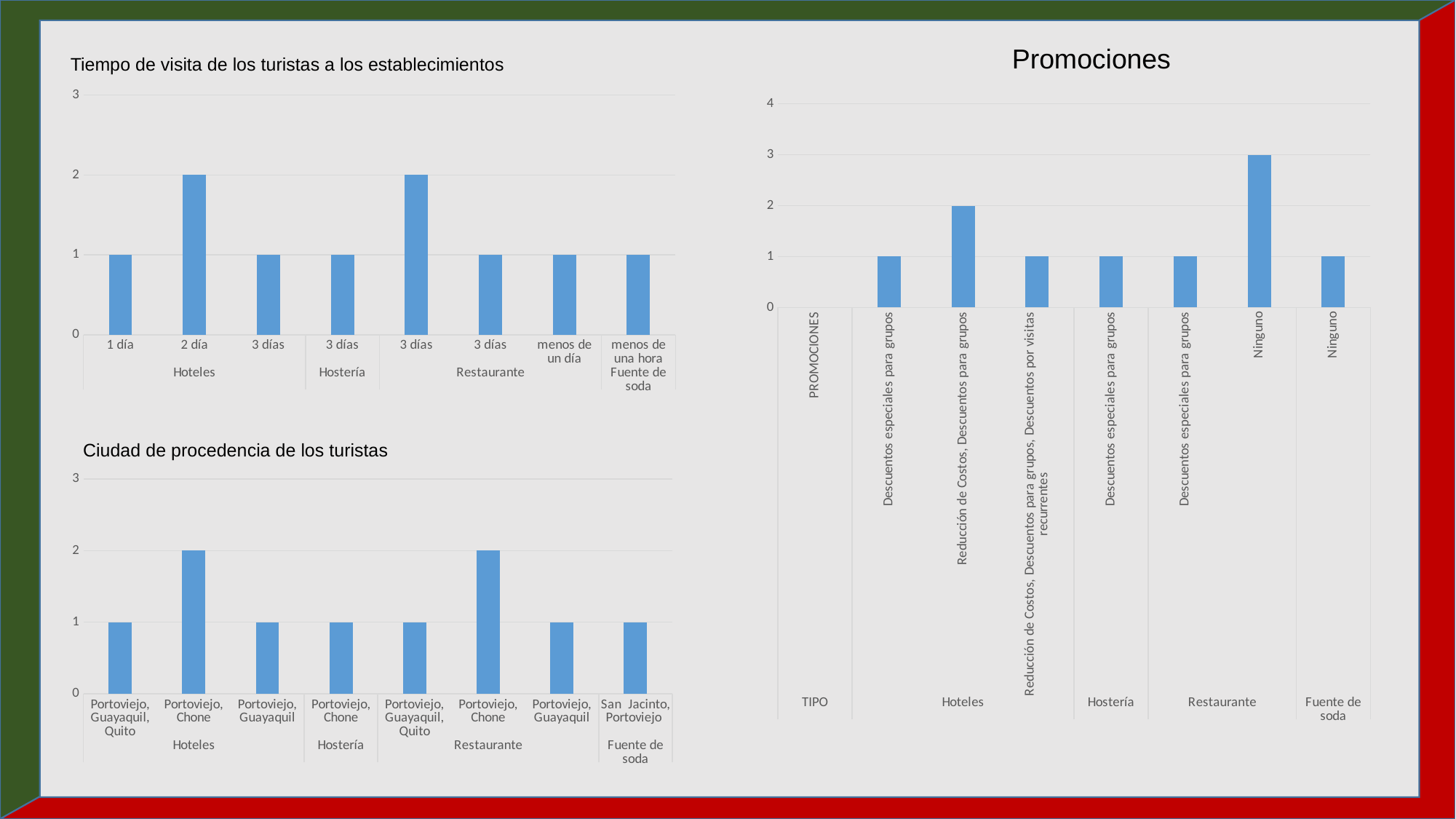
In the 'Promociones' chart, what is the value for 'Reducción de Costos, Descuentos para grupos' under Hoteles? 2 In the 'Tiempo de visita de los turistas a los establecimientos' chart, what is the value for 'menos de una hora' under Fuente de soda? 1 In the 'Ciudad de procedencia de los turistas' chart, what is the value for 'Portoviejo, Chone' under Hoteles? 2 In the 'Tiempo de visita de los turistas a los establecimientos' chart, what is the value for '2 día' under Hoteles? 2 In the 'Promociones' chart, which category has the highest value? Ninguno (Restaurante) In the 'Promociones' chart, what is the difference between 'Ninguno' under Restaurante and 'Ninguno' under Fuente de soda? 2 In the 'Tiempo de visita de los turistas a los establecimientos' chart, how many bars are plotted? 8 What is the highest value shown on the vertical axis of the 'Promociones' chart? 4 In the 'Ciudad de procedencia de los turistas' chart, which is larger: 'Portoviejo, Chone' under Restaurante or 'San Jacinto, Portoviejo' under Fuente de soda? Portoviejo, Chone (Restaurante) What kind of chart is the 'Ciudad de procedencia de los turistas' chart? Bar chart In the 'Promociones' chart, how many bars are plotted? 7 In the 'Promociones' chart, what is the value for 'Ninguno' under Restaurante? 3